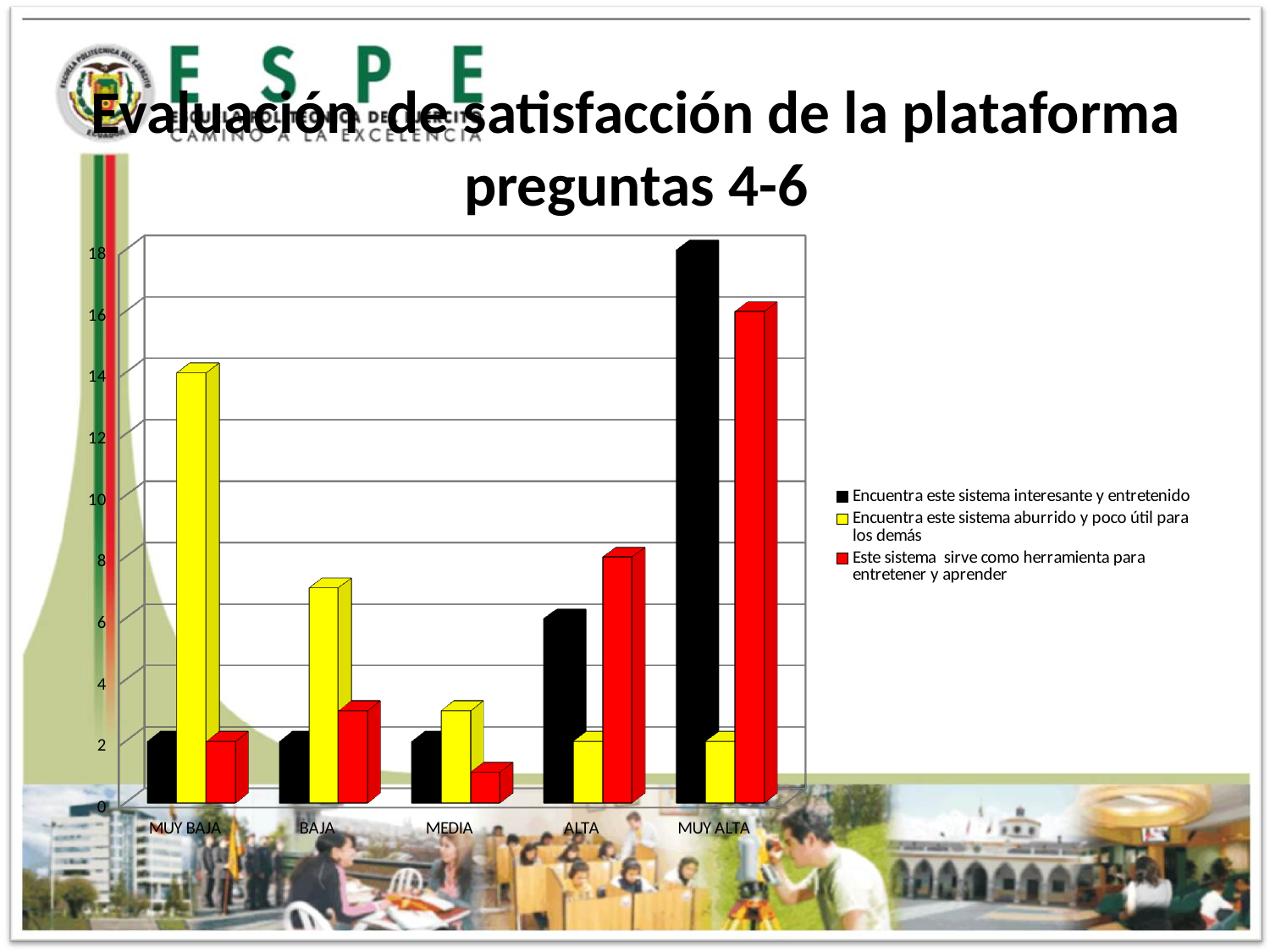
What is the value for MUY ALTA in the series 'Este sistema sirve como herramienta para entretener y aprender'? 16 How many series does the legend list? 3 What is the value for MUY BAJA in the series 'Encuentra este sistema aburrido y poco útil para los demás'? 14 For MUY ALTA, which series has the larger value: 'Encuentra este sistema interesante y entretenido' or 'Este sistema sirve como herramienta para entretener y aprender'? Encuentra este sistema interesante y entretenido Is the value for BAJA in the series 'Encuentra este sistema aburrido y poco útil para los demás' greater or less than 6? greater What is the value for MUY ALTA in the series 'Encuentra este sistema interesante y entretenido'? 18 Which category has the highest value in the series 'Encuentra este sistema aburrido y poco útil para los demás'? MUY BAJA What is the value for ALTA in the series 'Este sistema sirve como herramienta para entretener y aprender'? 8 Which category has the highest value in the series 'Encuentra este sistema interesante y entretenido'? MUY ALTA Do the values for the series 'Encuentra este sistema aburrido y poco útil para los demás' rise or fall from MUY BAJA to MUY ALTA? fall How many categories are shown on the x axis? 5 What kind of chart is shown on the slide? bar chart